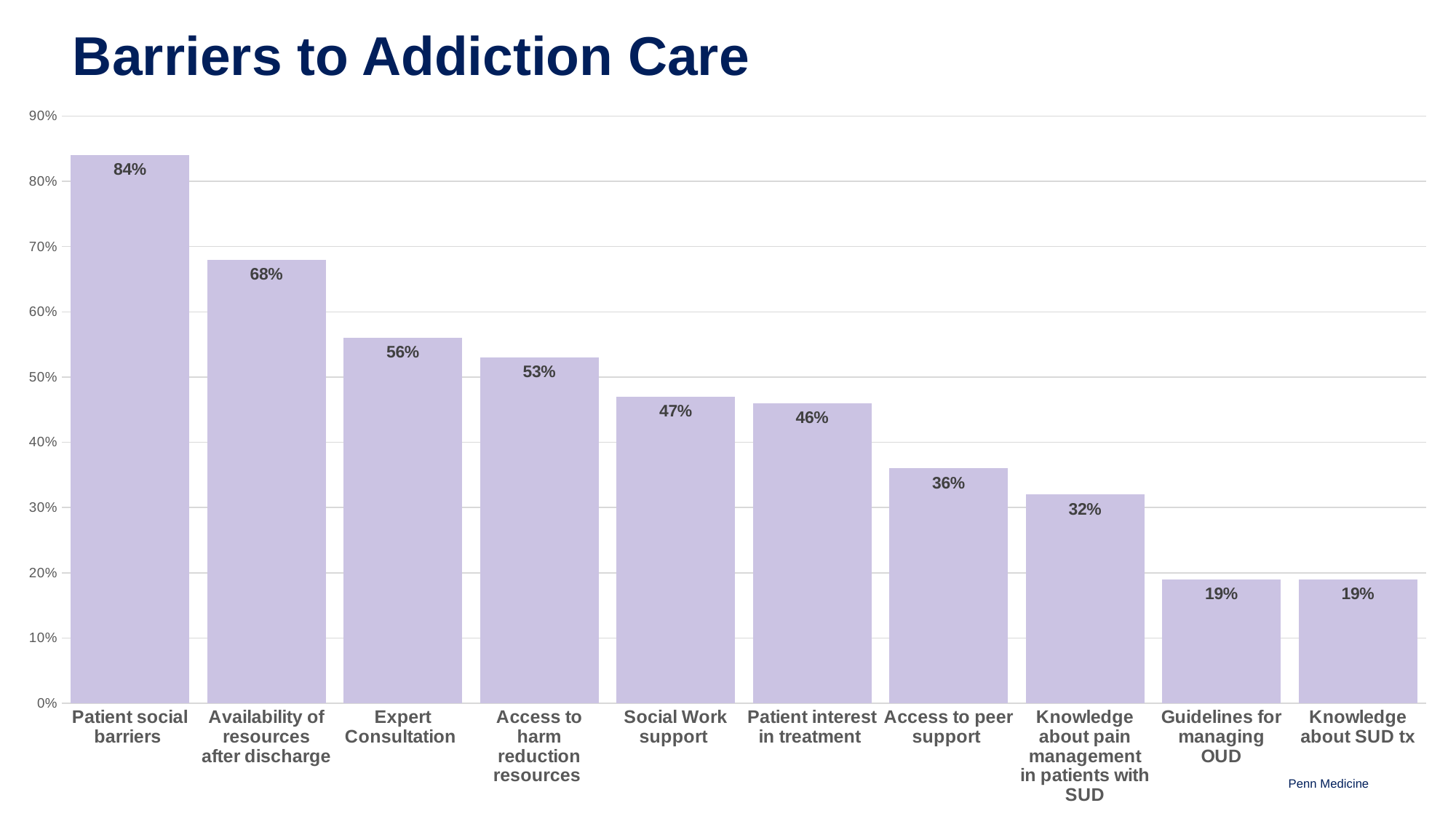
How many categories are shown in the chart? 10 Which is larger, Expert Consultation or Patient interest in treatment? Expert Consultation What is the value for Knowledge about pain management in patients with SUD? 32% Which category has the highest value? Patient social barriers What is the difference between Social Work support and Access to peer support? 11% What is the value for Access to harm reduction resources? 53% What kind of chart is shown on the slide? Bar chart What is the value for Patient social barriers? 84% Do the values rise or fall from left to right along the x axis? Fall What is the title of the chart? Barriers to Addiction Care Is the value for Access to peer support greater or less than 40%? less What is the difference between Availability of resources after discharge and Expert Consultation? 12%